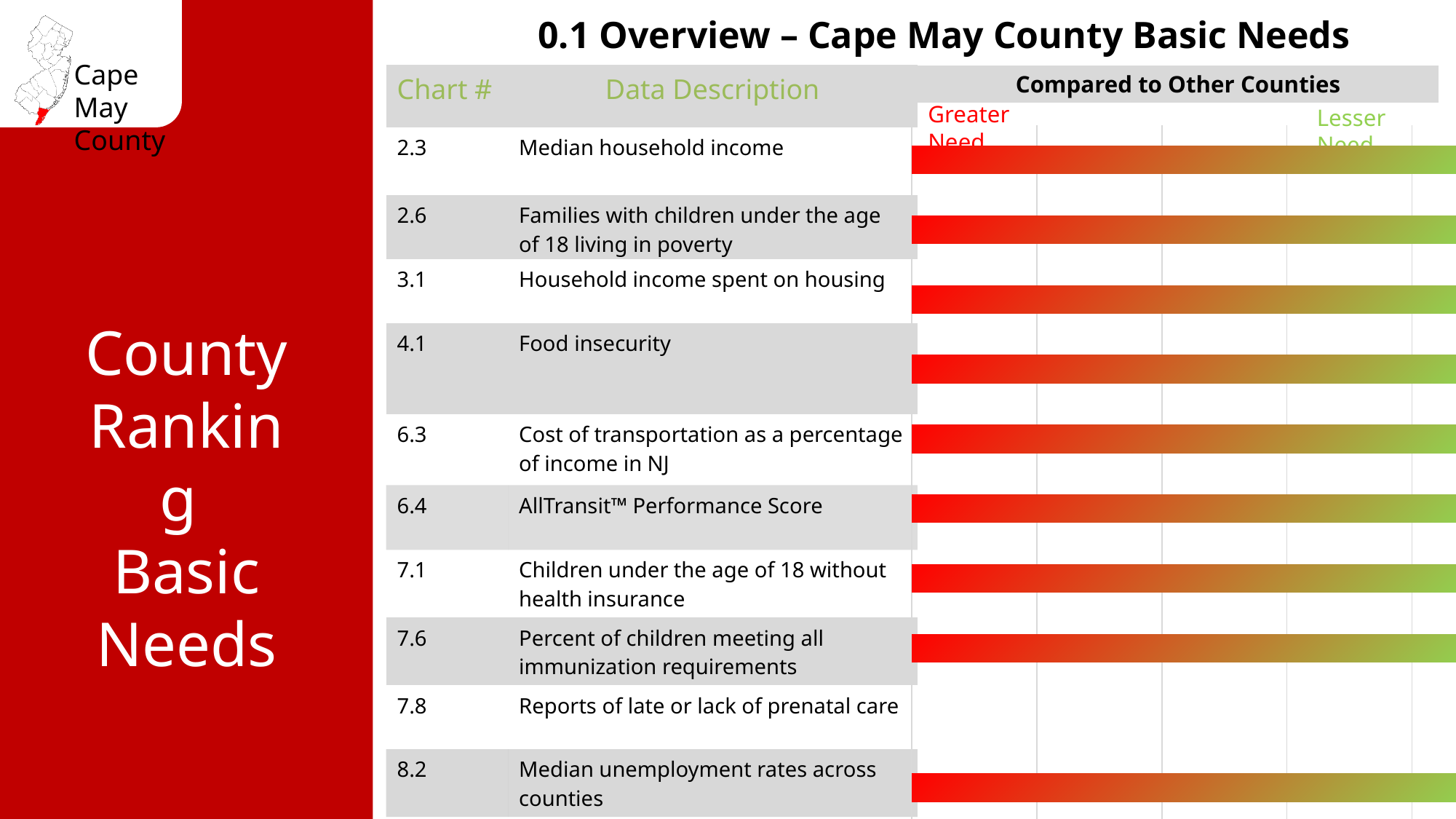
Which chart number is listed for 'Median household income'? 2.3 What does the red end of the bars in the 'Compared to Other Counties' column indicate? Greater Need Which chart number is listed for 'Food insecurity'? 4.1 What data description is listed for chart number 7.8? Reports of late or lack of prenatal care How many data descriptions are listed in the table? 10 What does the green end of the bars in the 'Compared to Other Counties' column indicate? Lesser Need What data description is listed for chart number 6.4? AllTransit™ Performance Score Which chart number is listed for 'Median unemployment rates across counties'? 8.2